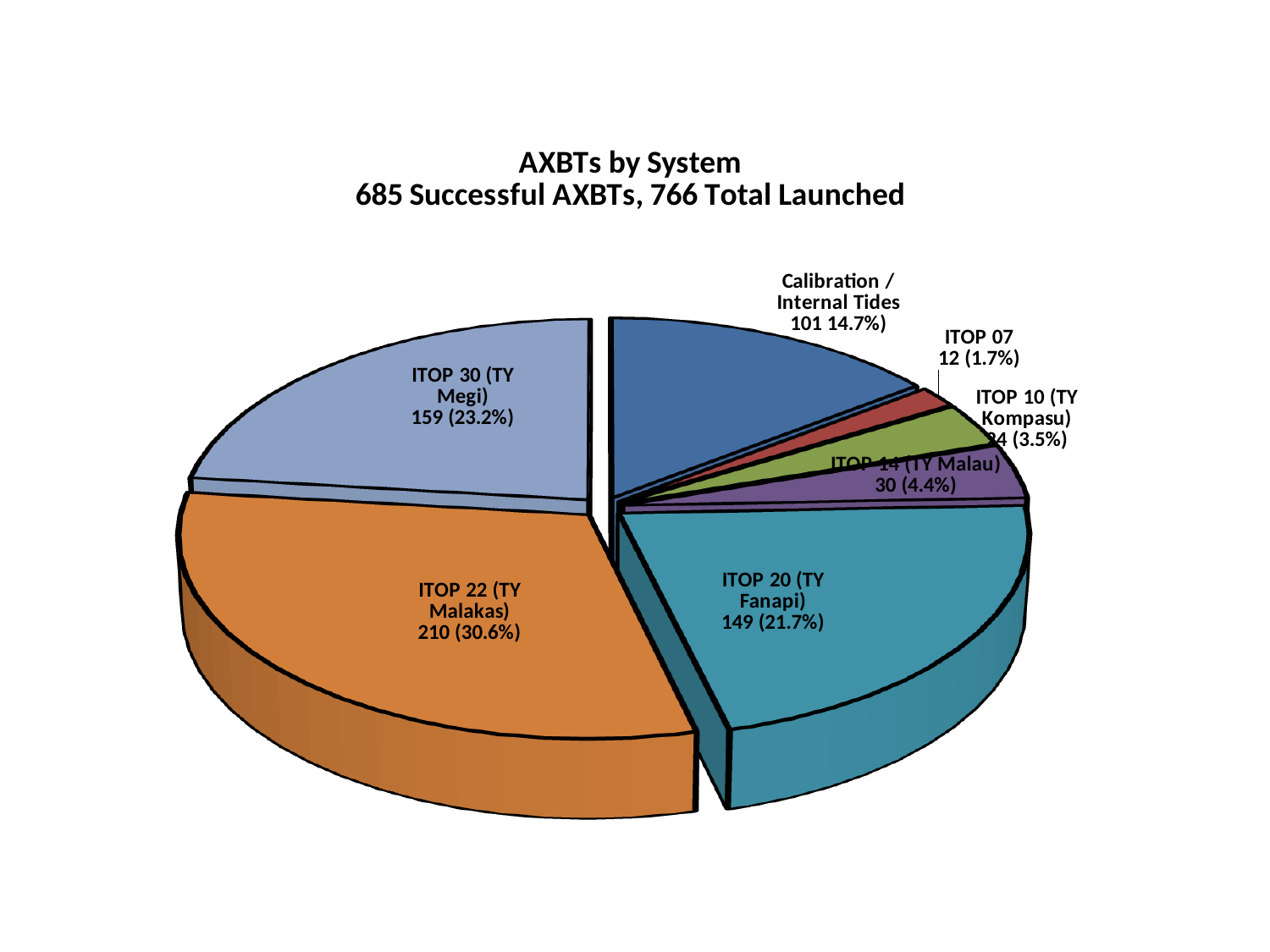
How many AXBTs are shown for Calibration / Internal Tides? 101 Which system has the smallest slice of the pie? ITOP 07 How many successful AXBTs are shown for ITOP 22 (TY Malakas)? 210 What is the difference in AXBT count between ITOP 30 (TY Megi) and ITOP 20 (TY Fanapi)? 10 Which has more AXBTs, ITOP 30 (TY Megi) or ITOP 20 (TY Fanapi)? ITOP 30 (TY Megi) How many slices does the pie chart have? 7 What share of the pie does ITOP 20 (TY Fanapi) represent? 21.7% What kind of chart is shown on the slide? pie chart Which system has the largest slice of the pie? ITOP 22 (TY Malakas) What is the difference in AXBT count between ITOP 22 (TY Malakas) and ITOP 30 (TY Megi)? 51 What is the title of the chart? AXBTs by System 685 Successful AXBTs, 766 Total Launched What percentage of the pie is ITOP 14 (TY Malau)? 4.4%